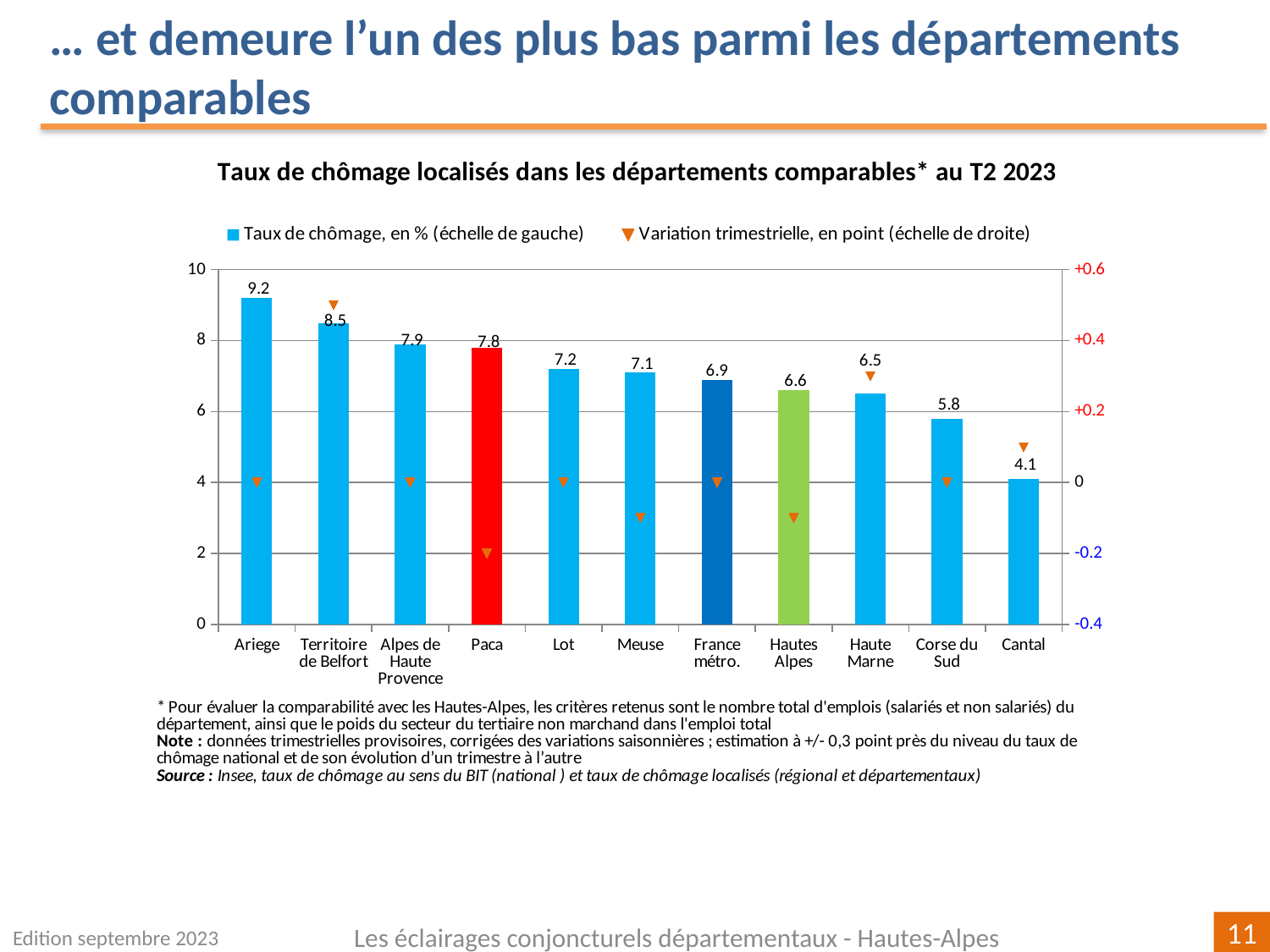
What is the unemployment rate shown for Ariege? 9.2 Which department has the highest unemployment rate on the chart? Ariege Is the quarterly variation (right axis) for Paca greater or less than 0? less Which department has the lowest unemployment rate on the chart? Cantal How many departments or areas are shown on the x axis? 11 How many series does the legend list? 2 What is the unemployment rate shown for Hautes Alpes? 6.6 What is the difference between the unemployment rates of Ariege and Cantal? 5.1 Is the quarterly variation (right axis) for Territoire de Belfort greater or less than +0.4? greater What type of chart is used to show the unemployment rates? bar chart Which has a higher unemployment rate, Lot or Corse du Sud? Lot What is the unemployment rate shown for France métro.? 6.9